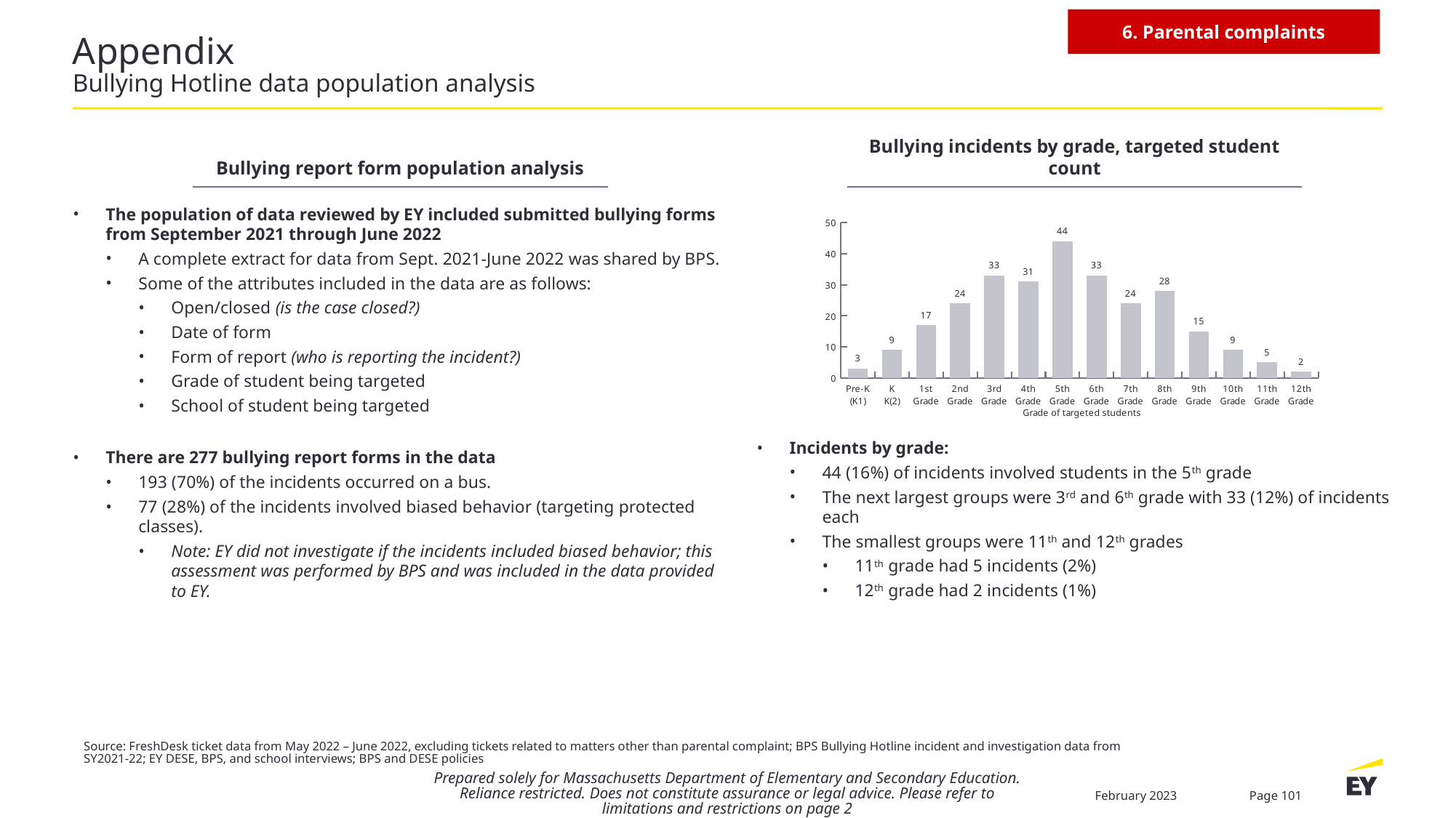
Which has a higher count, 4th Grade or 7th Grade? 4th Grade What is the title of the chart? Bullying incidents by grade, targeted student count Which grade has the highest number of bullying incidents? 5th Grade What is the targeted student count for 8th Grade? 28 What is the targeted student count for 5th Grade? 44 What is the difference between the counts for 5th Grade and 6th Grade? 11 How many grade categories are shown on the x axis? 14 What type of chart is used to show bullying incidents by grade? Bar chart Which grade has the lowest number of bullying incidents? 12th Grade Is the value for 9th Grade greater or less than 20? less Do the values rise or fall from 8th Grade to 12th Grade? Fall What is the targeted student count for Pre-K (K1)? 3